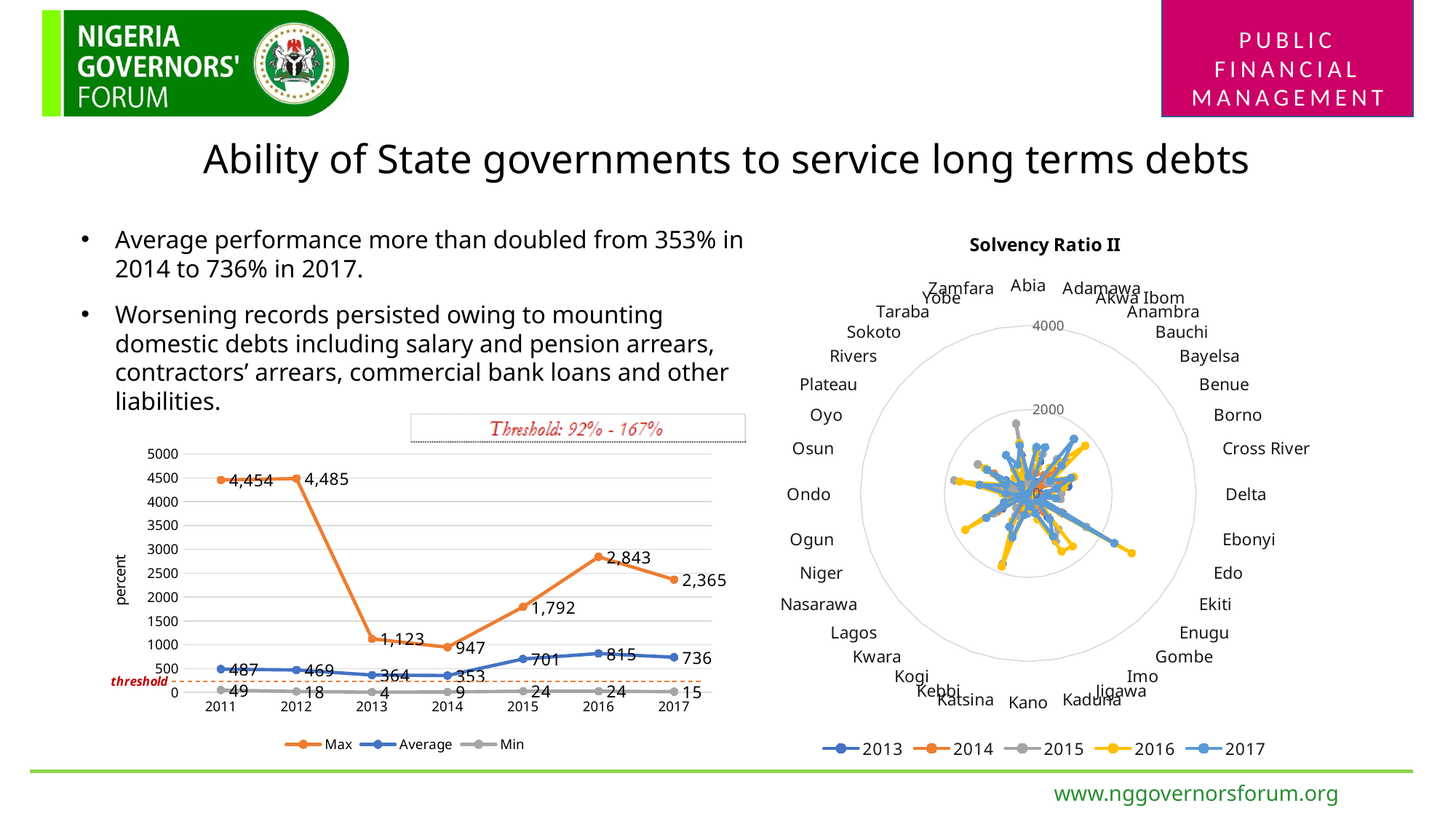
In the left line chart, what is the difference between the Average values for 2016 and 2015? 114 In the left line chart, which year has the lowest Average value? 2014 In the left line chart, which is larger: the Max value for 2016 or the Max value for 2017? 2016 What is the title of the chart on the right? Solvency Ratio II In the left line chart, does the Average series rise or fall from 2014 to 2016? rise In the left line chart, which year has the highest Max value? 2012 In the left line chart, what is the Average value for 2017? 736 In the Solvency Ratio II chart on the right, how many series does the legend list? 5 In the left line chart, what is the Min value for 2013? 4 In the left line chart, how many years are plotted on the x axis? 7 In the left line chart, how many series does the legend list? 3 In the left line chart, what is the Max value for 2012? 4,485